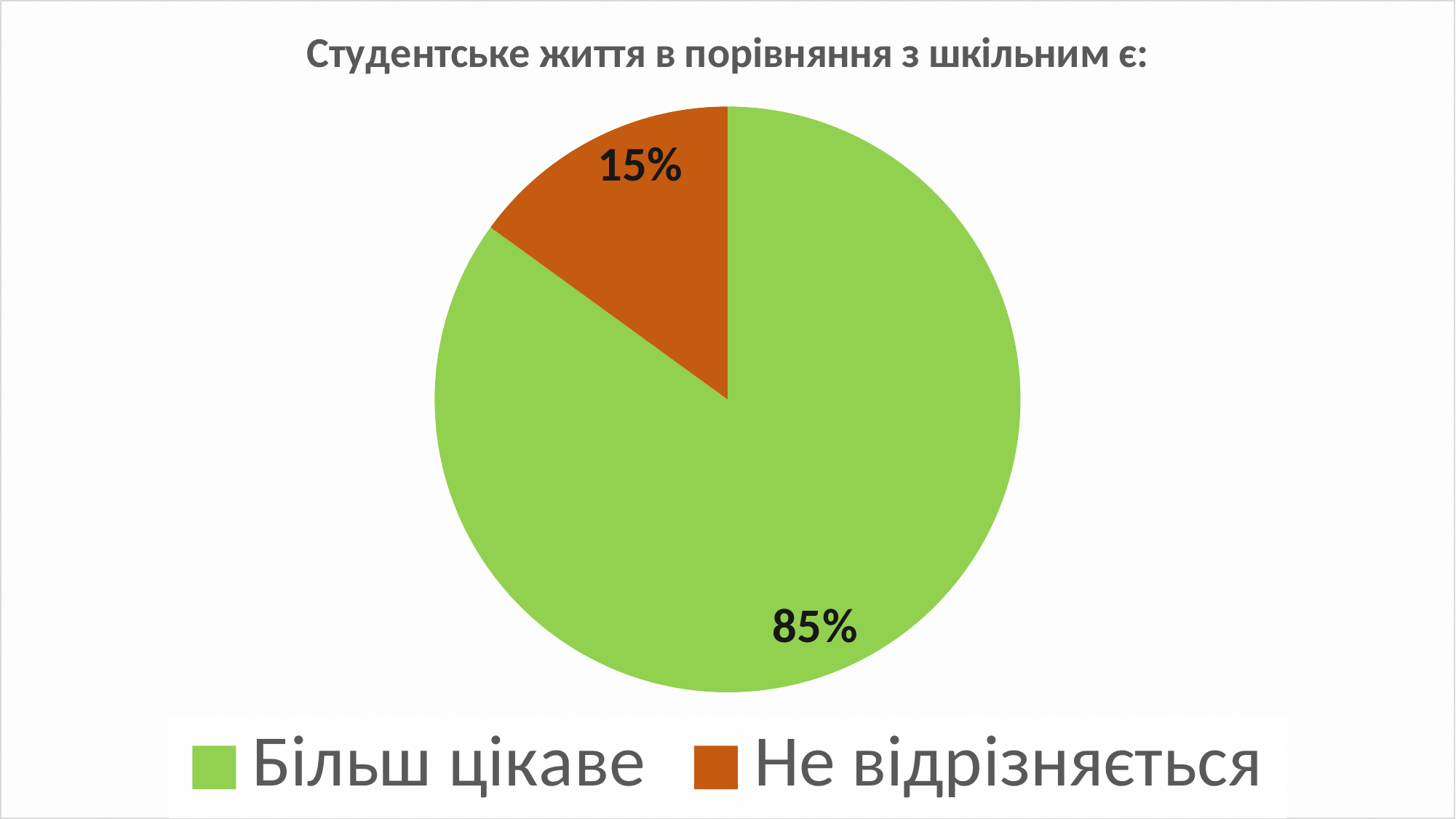
What colour is the slice for "Не відрізняється"? Orange How many entries does the legend list? 2 Which category has the largest share of the pie? Більш цікаве What is the difference in percentage points between "Більш цікаве" and "Не відрізняється"? 70 What percentage of the pie is labelled "Більш цікаве"? 85% Which is larger: the share for "Більш цікаве" or the share for "Не відрізняється"? Більш цікаве What is the title of the chart? Студентське життя в порівняння з шкільним є: What share of the pie does the "Більш цікаве" slice represent? 85% What type of chart is shown on the slide? Pie chart How many slices does the pie chart have? 2 Which category has the smallest share of the pie? Не відрізняється What percentage of the pie is labelled "Не відрізняється"? 15%